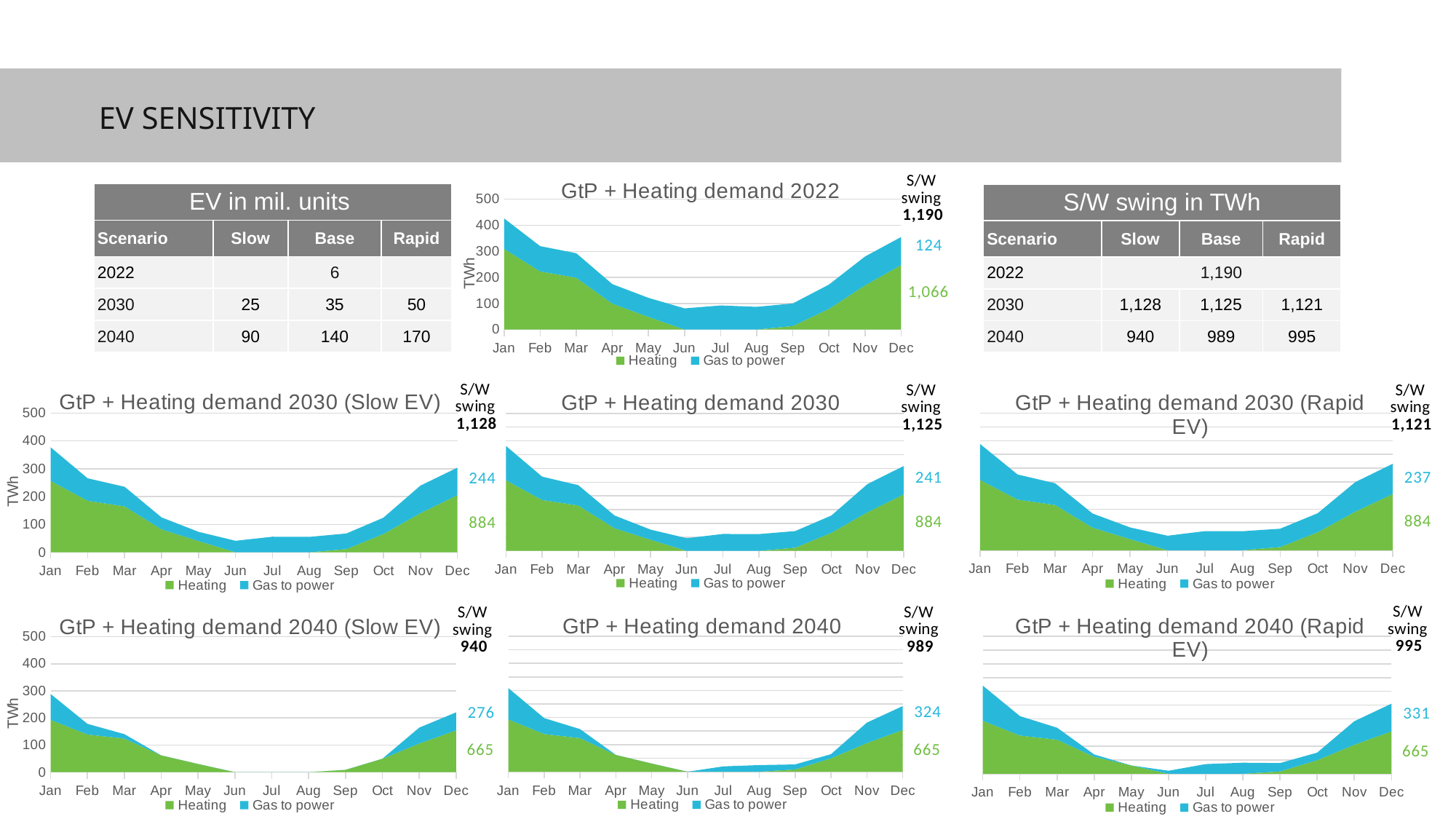
In "GtP + Heating demand 2030", do the stacked values rise or fall from Jan to Jun? fall In "GtP + Heating demand 2022", is the total stacked value for Jan greater or less than 400? greater What S/W swing value is printed next to "GtP + Heating demand 2022"? 1,190 How many series does the legend of "GtP + Heating demand 2030 (Slow EV)" list? 2 What Gas to power value (blue) is printed next to "GtP + Heating demand 2040 (Rapid EV)"? 331 In "GtP + Heating demand 2030 (Slow EV)", what is the sum of the printed Gas to power (244) and Heating (884) values? 1,128 What is the difference between the printed Gas to power values for "GtP + Heating demand 2040 (Rapid EV)" (331) and "GtP + Heating demand 2040 (Slow EV)" (276)? 55 In "GtP + Heating demand 2040 (Slow EV)", is the total stacked value for Jan greater or less than 300? less What Heating value (green) is printed next to "GtP + Heating demand 2030 (Slow EV)"? 884 What kind of chart is "GtP + Heating demand 2022"? stacked area chart Which chart has the larger printed S/W swing: "GtP + Heating demand 2040 (Slow EV)" or "GtP + Heating demand 2040 (Rapid EV)"? GtP + Heating demand 2040 (Rapid EV) How many months are plotted along the x axis of "GtP + Heating demand 2040"? 12